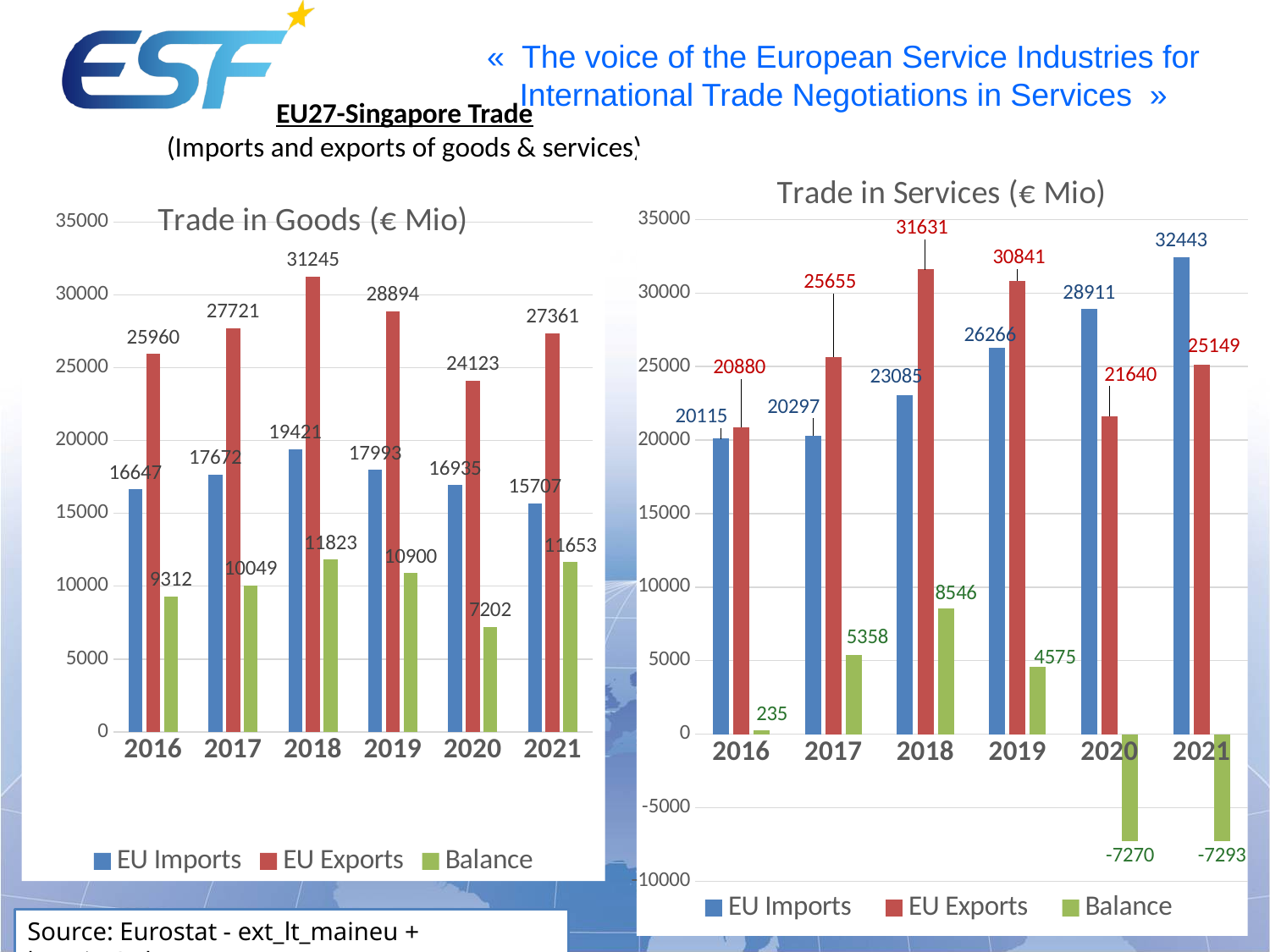
In the Trade in Services chart, what is the Balance value for 2020? -7270 In the Trade in Services chart, which is larger in 2020: EU Imports or EU Exports? EU Imports In the Trade in Services chart, which year has the highest EU Exports value? 2018 In the Trade in Goods chart, what is the difference between EU Exports and EU Imports in 2021? 11654 How many years are shown on the x axis of the Trade in Goods chart? 6 What type of chart is the Trade in Goods chart? bar chart In the Trade in Goods chart, what is the value of EU Exports in 2018? 31245 How many series does the legend of the Trade in Services chart list? 3 In the Trade in Services chart, do EU Imports rise or fall from 2016 to 2021? rise In the Trade in Goods chart, which year has the highest EU Exports value? 2018 In the Trade in Services chart, what is the value of EU Imports in 2021? 32443 In the Trade in Goods chart, which year has the lowest Balance value? 2020